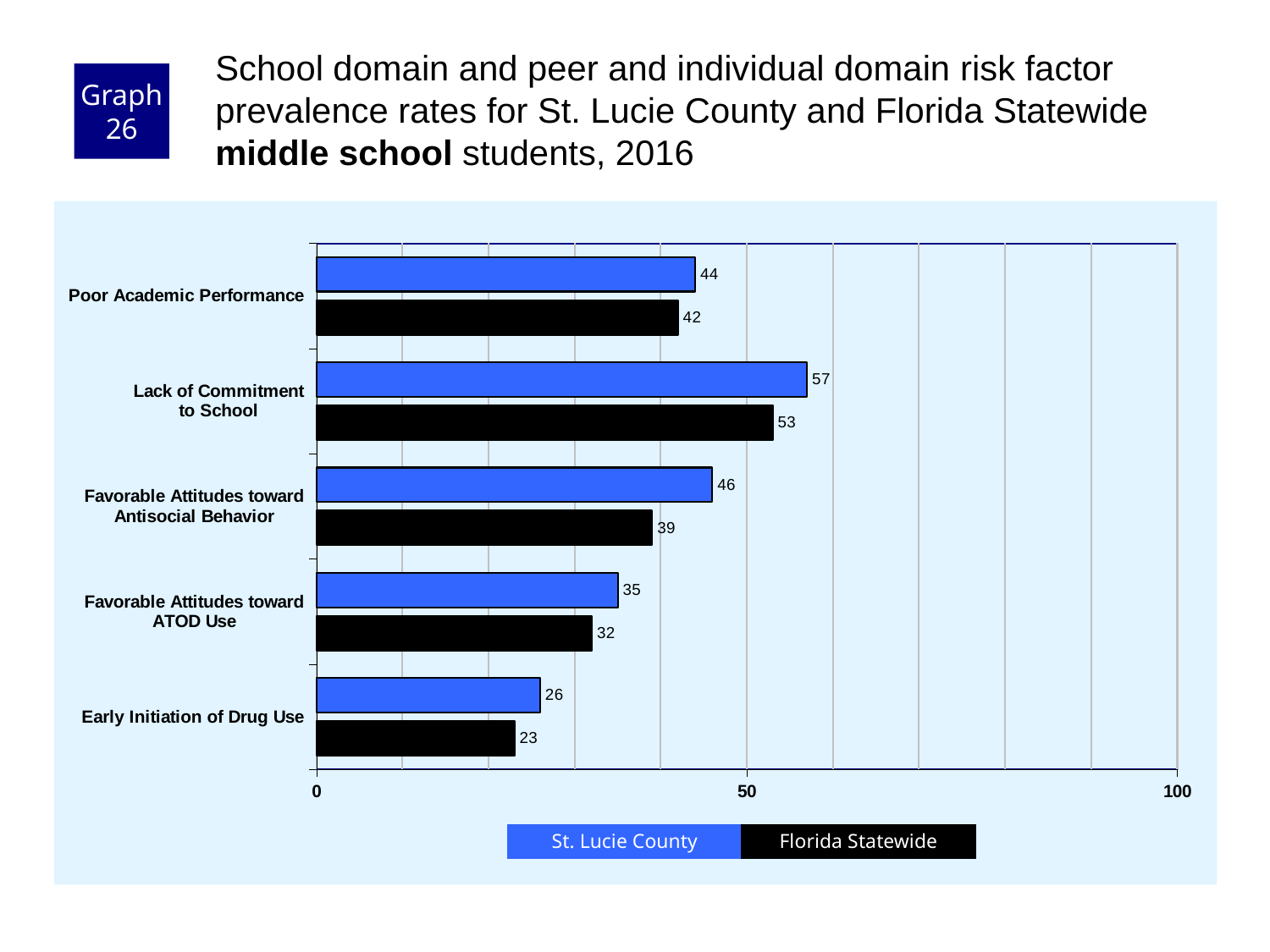
What is the St. Lucie County value for Lack of Commitment to School? 57 How many series does the legend list? 2 Is the St. Lucie County value for Favorable Attitudes toward ATOD Use greater or less than 50? less Which is larger for Poor Academic Performance: the St. Lucie County value or the Florida Statewide value? St. Lucie County Which risk factor has the lowest Florida Statewide value? Early Initiation of Drug Use What is the difference between the St. Lucie County and Florida Statewide values for Favorable Attitudes toward Antisocial Behavior? 7 What is the difference between the St. Lucie County and Florida Statewide values for Lack of Commitment to School? 4 What is the Florida Statewide value for Early Initiation of Drug Use? 23 How many risk factors are shown on the chart? 5 What is the Florida Statewide value for Favorable Attitudes toward Antisocial Behavior? 39 Which risk factor has the highest St. Lucie County value? Lack of Commitment to School What kind of chart is shown on the slide? bar chart